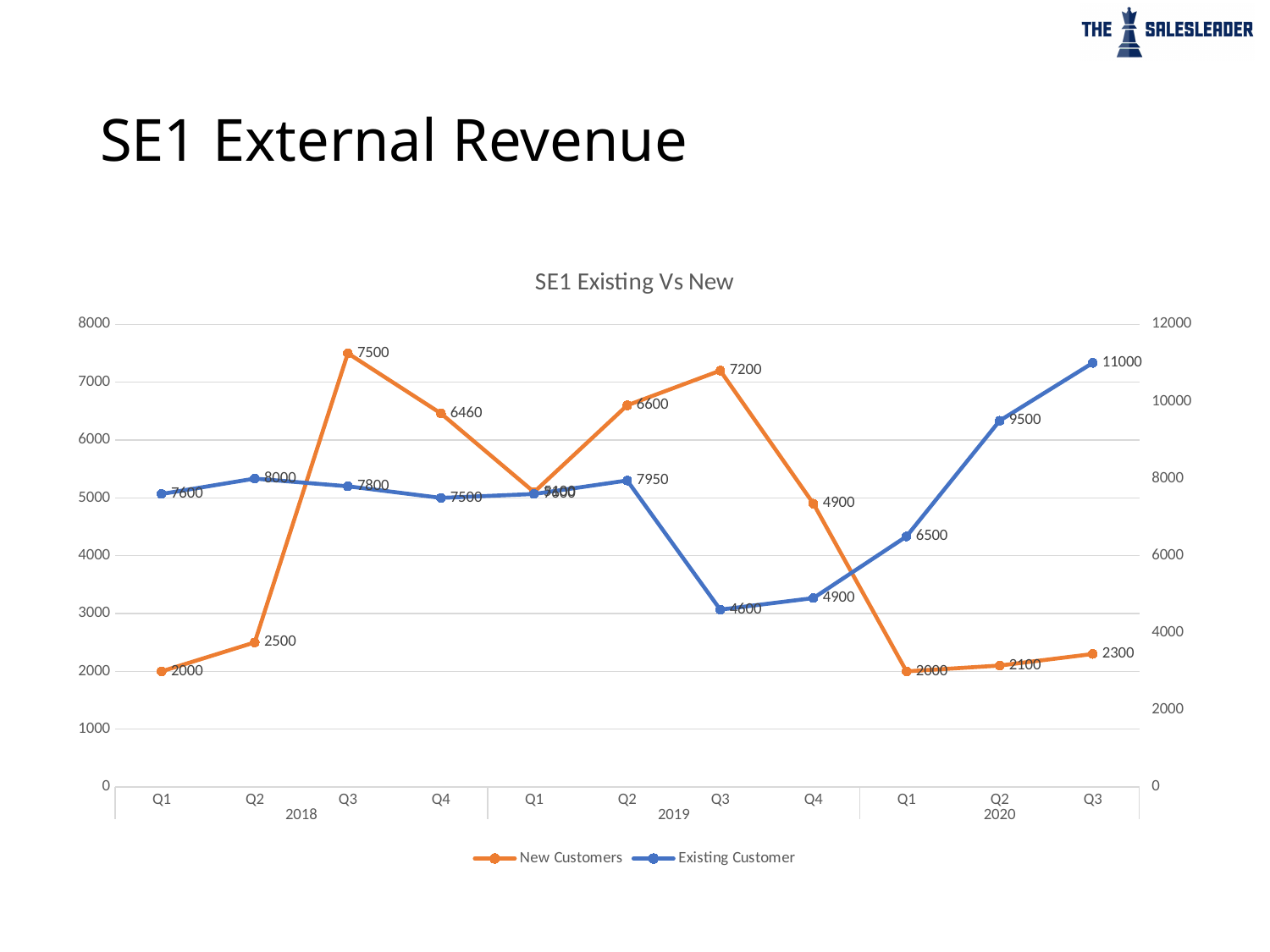
How many series does the legend list? 2 How many quarters are plotted along the x axis? 11 In which quarter is the Existing Customer value lowest? Q3 2019 What is the difference between the New Customers values in Q3 2018 and Q2 2018? 5000 Which is larger for New Customers: Q3 2019 or Q2 2019? Q3 2019 What is the value for Existing Customer in Q3 2020? 11000 What is the title of the chart? SE1 Existing Vs New What is the value for New Customers in Q4 2019? 4900 What type of chart is shown on the slide? line chart In which quarter is the Existing Customer value highest? Q3 2020 What is the value for Existing Customer in Q3 2019? 4600 What is the value for New Customers in Q3 2018? 7500